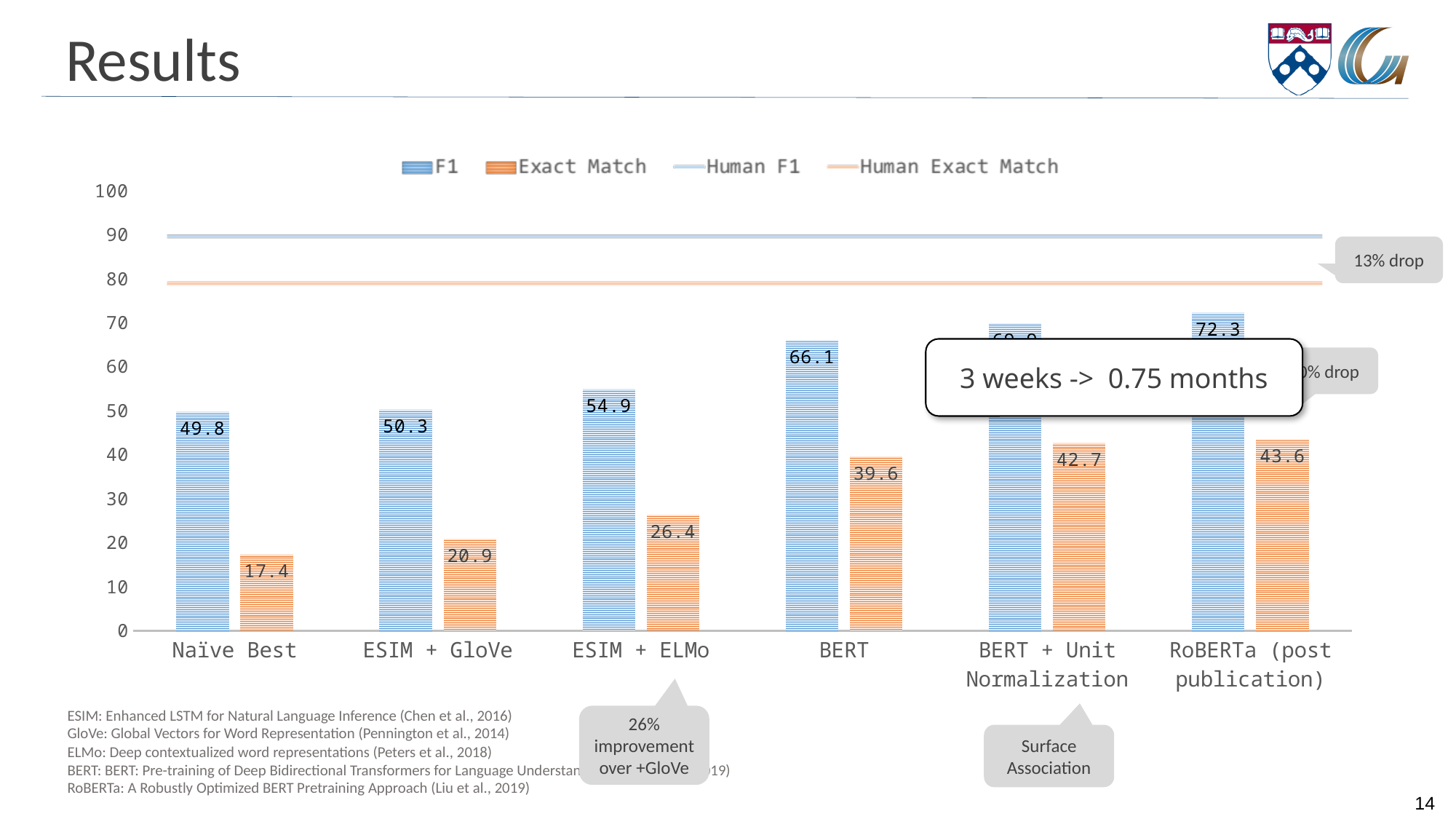
What is the Exact Match value for Naïve Best? 17.4 Which model has the lowest F1 value? Naïve Best How many series does the legend list? 4 Which model has the highest Exact Match value? RoBERTa (post publication) Do the Exact Match values rise or fall from left to right across the models? rise Is the Human F1 line greater or less than 80? greater What is the F1 value for ESIM + GloVe? 50.3 What is the Exact Match value for RoBERTa (post publication)? 43.6 What is the F1 value for BERT? 66.1 How many models are shown on the x axis? 6 Which has a larger Exact Match value, ESIM + GloVe or ESIM + ELMo? ESIM + ELMo What is the difference between the F1 value for BERT and the F1 value for ESIM + ELMo? 11.2